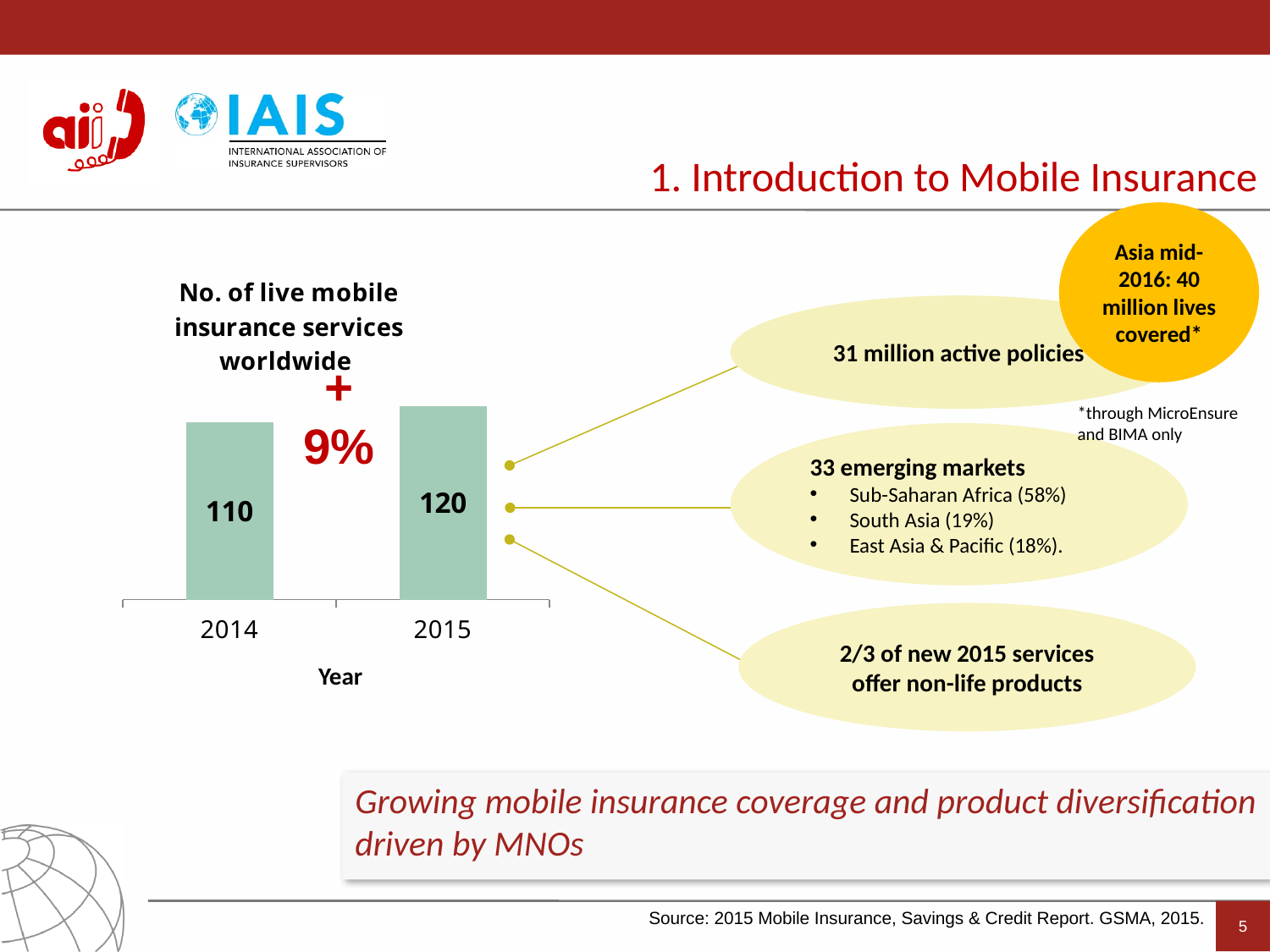
What percentage growth is annotated between the 2014 and 2015 bars? +9% Do the values rise or fall from 2014 to 2015? Rise What kind of chart is used to show the number of live mobile insurance services? Bar chart What is the number of live mobile insurance services worldwide in 2015? 120 Which year shows the lowest number of live mobile insurance services? 2014 What is the title of the chart? No. of live mobile insurance services worldwide How many years are shown on the x axis of the chart? 2 Which year has the higher number of live mobile insurance services, 2014 or 2015? 2015 What is the difference between the 2015 and 2014 values for live mobile insurance services? 10 What is the label of the x axis of the chart? Year What is the number of live mobile insurance services worldwide in 2014? 110